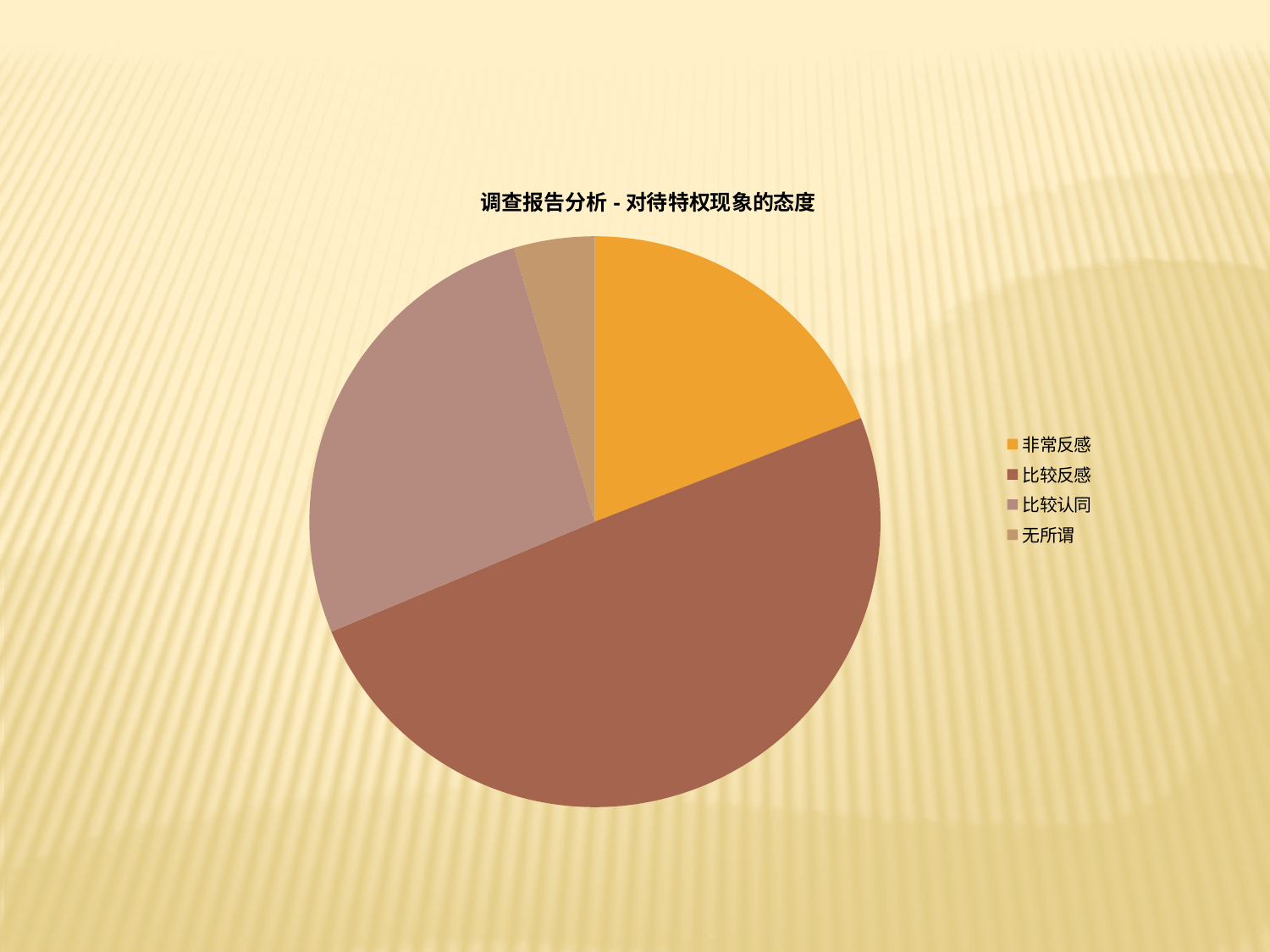
How many entries does the legend list? 4 How many slices does the pie chart have? 4 What is the title of the chart? 调查报告分析 - 对待特权现象的态度 What kind of chart is shown on the slide? pie chart Which category has the smallest slice of the pie? 无所谓 Which slice is larger, 比较反感 or 非常反感? 比较反感 Which category is shown in orange in the pie chart? 非常反感 Which category has the largest slice of the pie? 比较反感 Which slice is larger, 非常反感 or 无所谓? 非常反感 Which slice is larger, 比较认同 or 无所谓? 比较认同